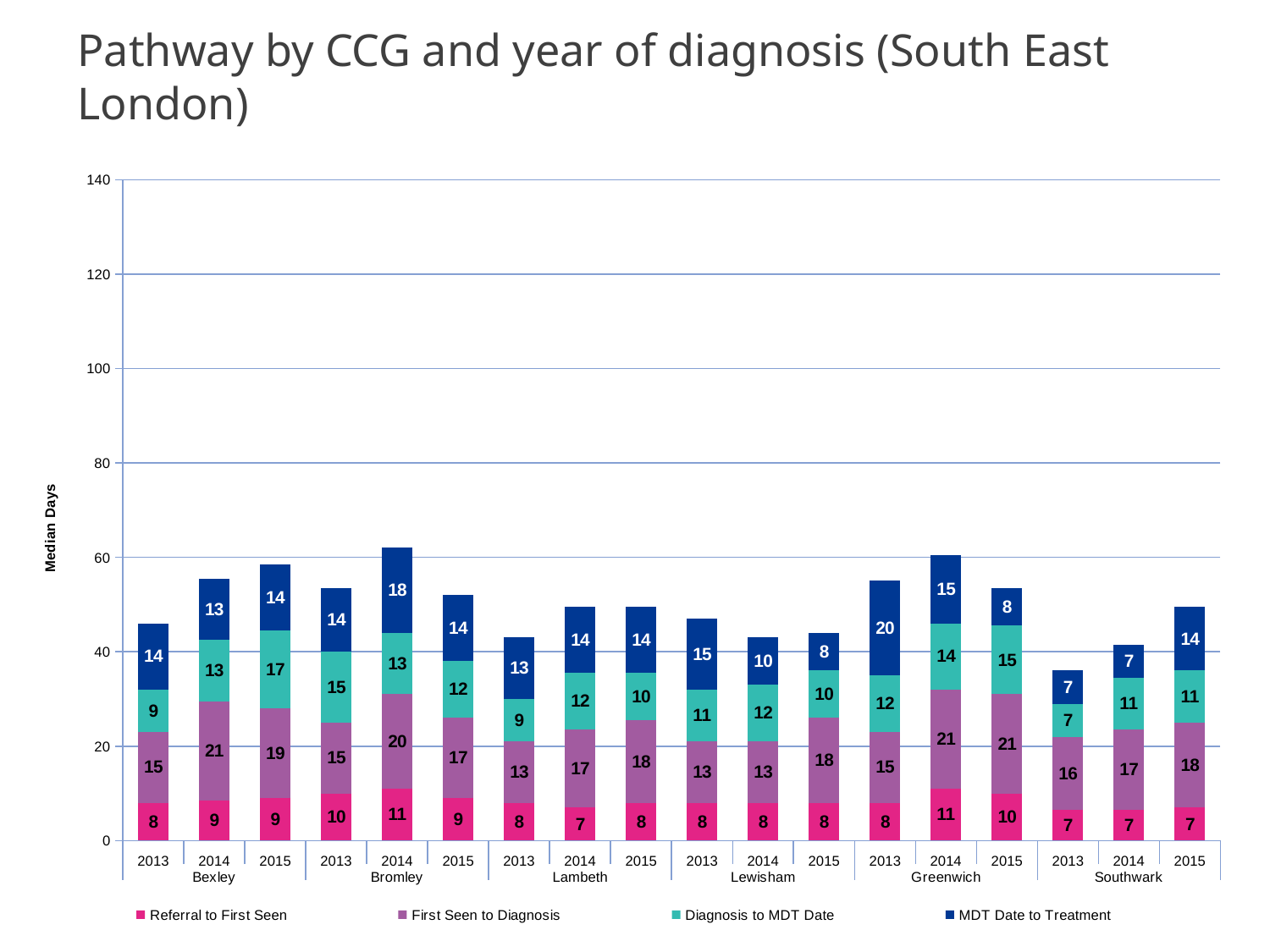
What is the value of MDT Date to Treatment for Greenwich in 2013? 20 Which is larger: First Seen to Diagnosis for Bexley 2014 or for Lambeth 2013? Bexley 2014 What is the total median days for the Bromley 2014 stacked bar? 62 What is the difference between the MDT Date to Treatment values for Greenwich 2013 and Greenwich 2015? 12 How many stacked bars are plotted on the chart? 18 What is the value of Diagnosis to MDT Date for Bexley in 2015? 17 What is the value of First Seen to Diagnosis for Southwark in 2015? 18 Is the total for the Bromley 2014 bar greater or less than 60? greater How many series does the legend list? 4 What kind of chart is shown on the slide? Stacked bar chart What is the total median days for the Southwark 2013 stacked bar? 37 What is the value of Referral to First Seen for Bromley in 2014? 11